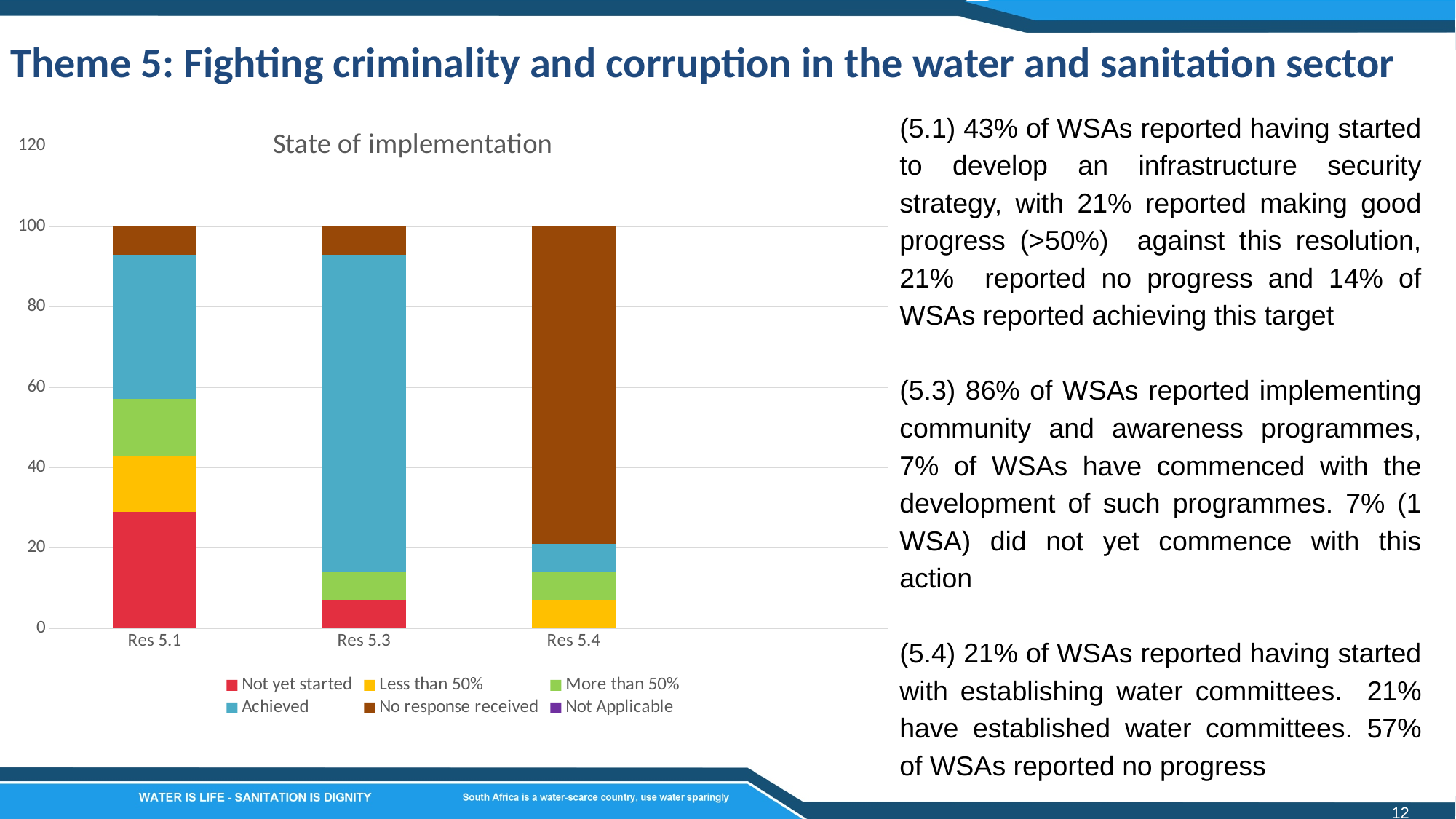
Which category has the largest 'Not yet started' segment? Res 5.1 Which is larger: the 'Not yet started' segment for Res 5.1 or for Res 5.3? Res 5.1 How many categories are shown on the x axis of the chart? 3 Which category has the largest 'Achieved' segment? Res 5.3 How many series does the chart legend list? 6 Is the 'Not yet started' value for Res 5.1 greater or less than 20? greater Is the 'No response received' value for Res 5.4 greater or less than 60? greater What is the title of the chart? State of implementation What is the total height of the stacked bar for Res 5.1? 100 What kind of chart is shown on the slide? Stacked bar chart Which category has the largest 'No response received' segment? Res 5.4 What is the total height of the stacked bar for Res 5.4? 100